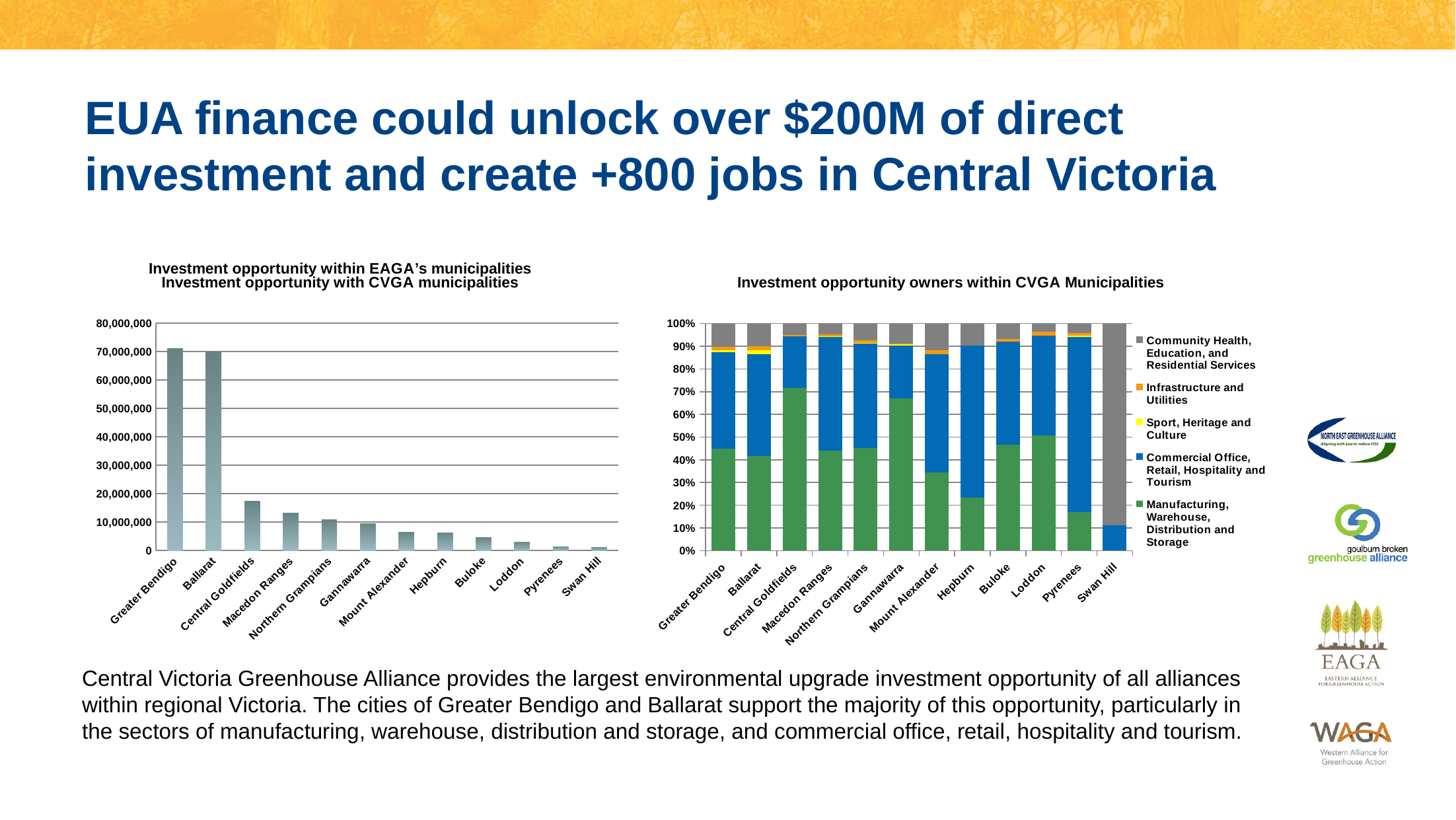
In the left chart, 'Investment opportunity with CVGA municipalities', which has the larger value, Central Goldfields or Macedon Ranges? Central Goldfields In the left chart, 'Investment opportunity with CVGA municipalities', is the value for Central Goldfields greater or less than 10,000,000? greater In the right chart, 'Investment opportunity owners within CVGA Municipalities', which municipality has the lowest Manufacturing, Warehouse, Distribution and Storage share? Swan Hill In the left chart, 'Investment opportunity with CVGA municipalities', is the value for Mount Alexander greater or less than 10,000,000? less How many municipalities are shown on the x axis of the left chart, 'Investment opportunity with CVGA municipalities'? 12 In the left chart, 'Investment opportunity with CVGA municipalities', is the value for Greater Bendigo greater or less than 60,000,000? greater What kind of chart is the right chart, 'Investment opportunity owners within CVGA Municipalities'? stacked bar chart How many series does the legend of the right chart, 'Investment opportunity owners within CVGA Municipalities', list? 5 In the left chart, 'Investment opportunity with CVGA municipalities', which has the larger value, Gannawarra or Buloke? Gannawarra In the right chart, 'Investment opportunity owners within CVGA Municipalities', which colour represents Community Health, Education, and Residential Services? grey What kind of chart is the left chart, 'Investment opportunity with CVGA municipalities'? bar chart